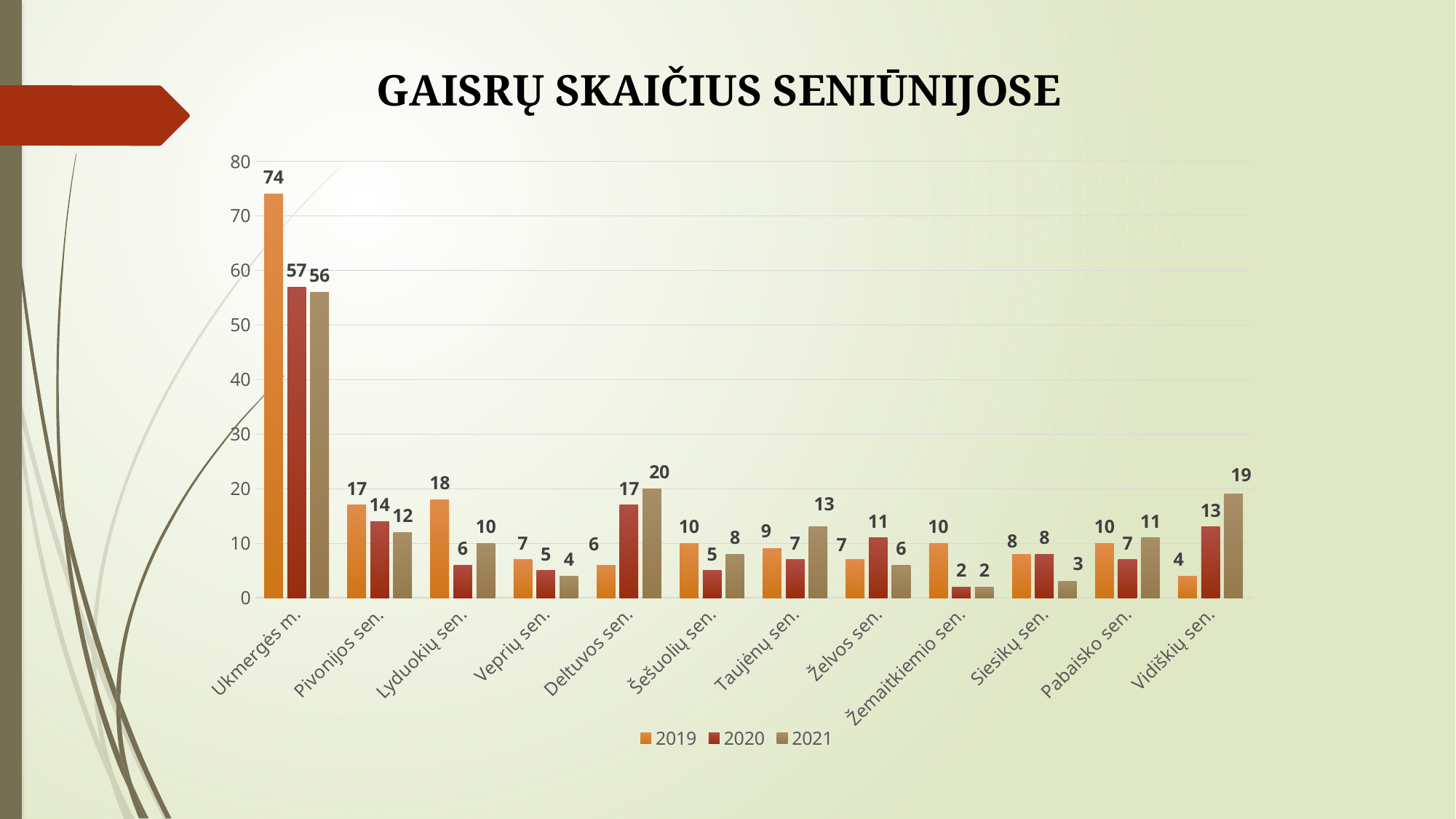
What is the difference between the 2019 and 2020 values for Ukmergės m.? 17 What is the value for Deltuvos sen. in the 2021 series? 20 Which is larger for Lyduokių sen.: the 2019 value or the 2021 value? 2019 What is the value for Vidiškių sen. in the 2020 series? 13 What is the value for Ukmergės m. in the 2019 series? 74 Is the 2020 value for Ukmergės m. greater or less than 50? greater What is the title of the chart? GAISRŲ SKAIČIUS SENIŪNIJOSE How many categories are shown on the x axis? 12 Which category has the highest value in the 2021 series? Ukmergės m. How many series does the legend list? 3 Which category has the lowest value in the 2020 series? Žemaitkiemio sen. What kind of chart is shown on the slide? Bar chart